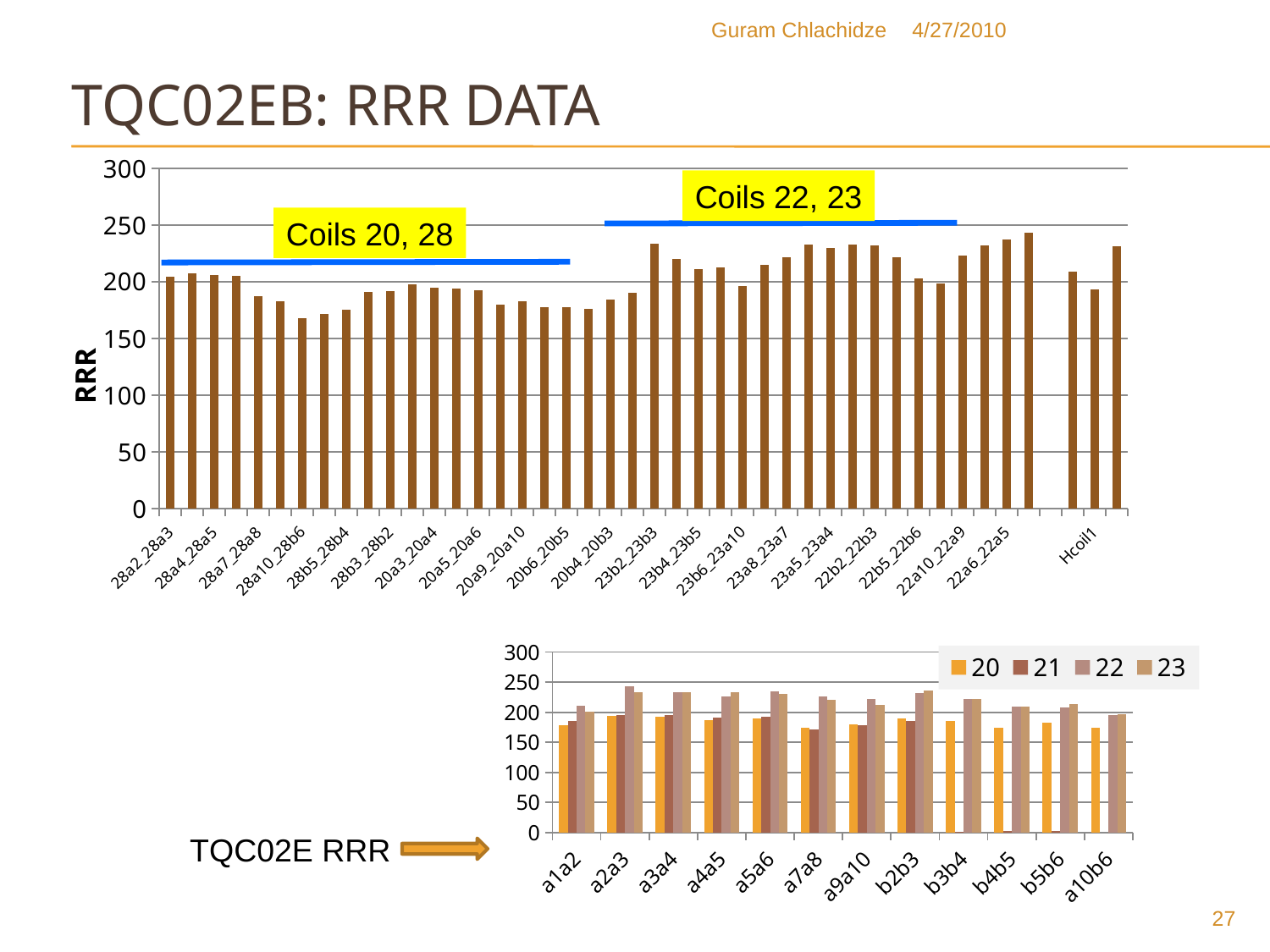
In the top chart, which is larger, the value for 23b2_23b3 or the value for 28a10_28b6? 23b2_23b3 In the bottom chart (TQC02E RRR), for category a2a3, which is larger, series 20 or series 22? 22 In the bottom chart (TQC02E RRR), is the value of series 22 for a2a3 greater or less than 200? greater In the top chart, is the value for 23b2_23b3 greater or less than 200? greater What kind of chart is the top chart on the slide? bar chart In the bottom chart (TQC02E RRR), how many series does the legend list? 4 In the bottom chart (TQC02E RRR), how many categories are shown on the x axis? 12 In the top chart, is the value for Hcoil1 greater or less than 200? less What is the y-axis title of the top chart? RRR